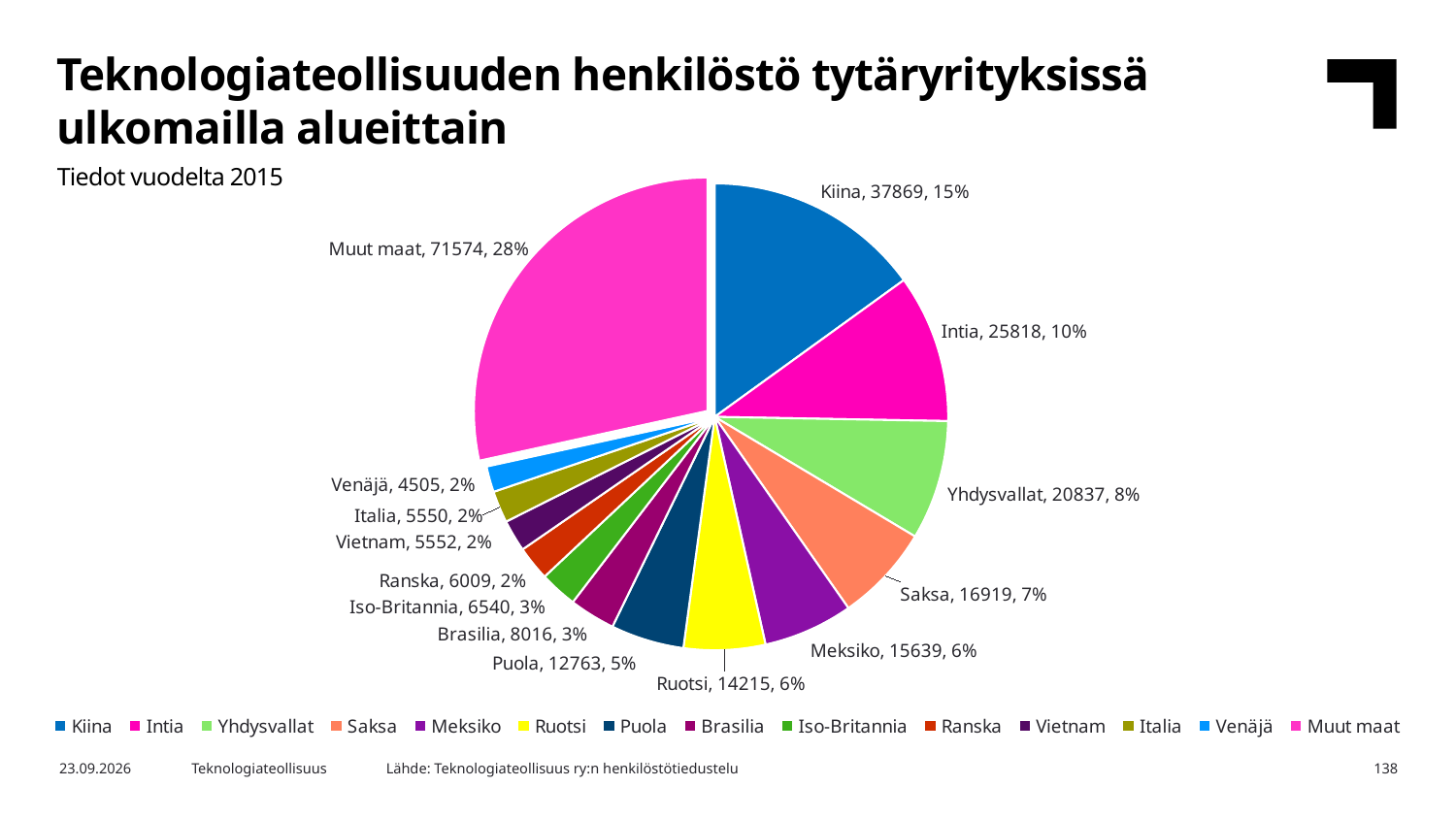
What is the value for Saksa? 16919 Which is larger, the value for Meksiko or the value for Ruotsi? Meksiko Which category has the smallest slice? Venäjä How many slices does the pie chart have? 14 What share of the pie does Muut maat represent? 28% What is the value for Kiina? 37869 What is the difference between the values for Kiina and Intia? 12051 What kind of chart is shown on the slide? pie chart What share of the pie does Yhdysvallat represent? 8% What is the value for Puola? 12763 Which category has the largest slice? Muut maat What year do the data on the chart come from, according to the subtitle? 2015